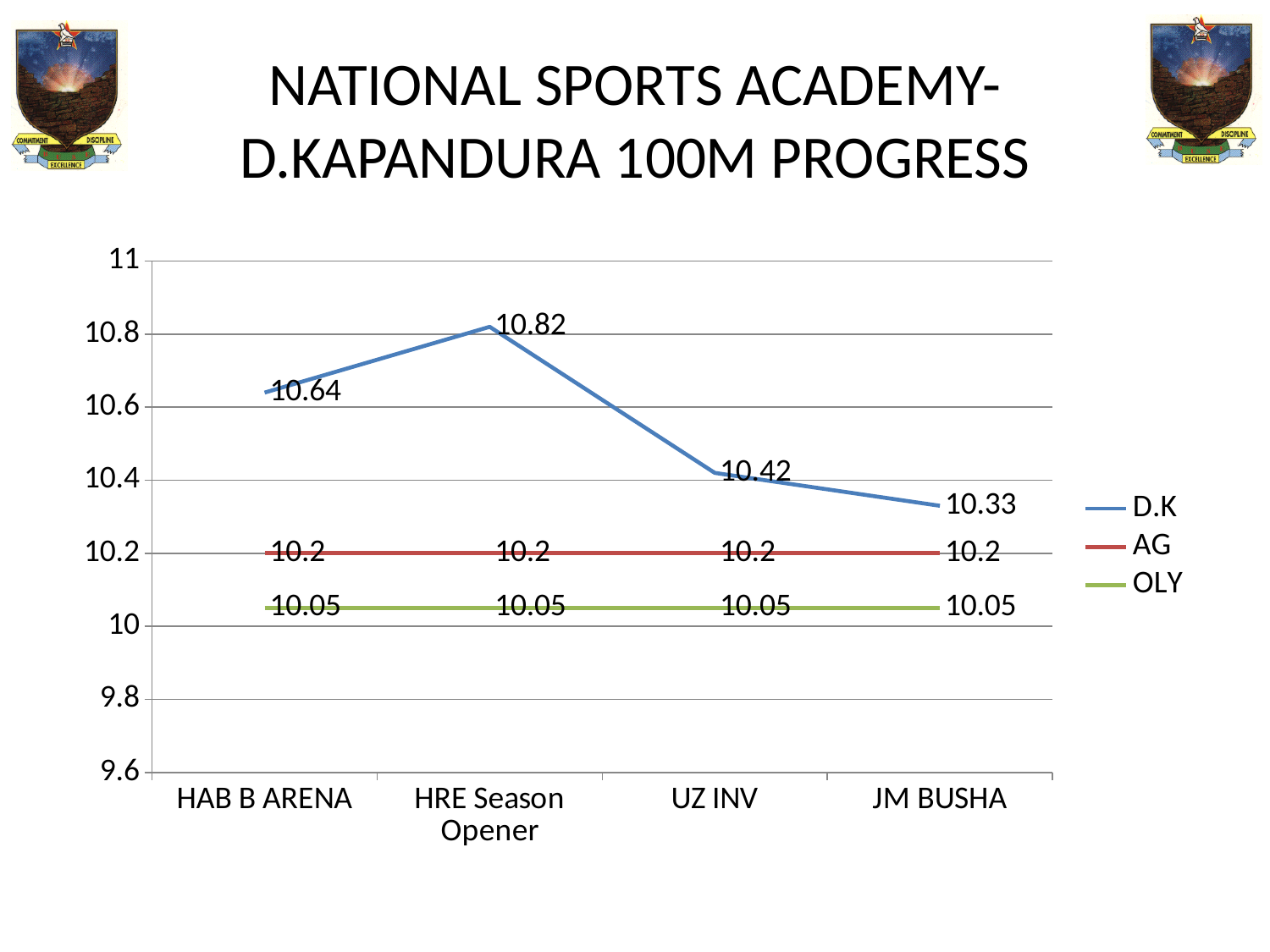
What is the D.K value at HRE Season Opener? 10.82 At which event is the D.K value highest? HRE Season Opener What is the OLY value at HAB B ARENA? 10.05 How many events are shown on the x axis? 4 What kind of chart is shown on the slide? Line chart At which event is the D.K value lowest? JM BUSHA What is the AG value at UZ INV? 10.2 What is the D.K value at JM BUSHA? 10.33 Does the D.K line rise or fall from HRE Season Opener to JM BUSHA? Fall Which is larger, the D.K value at HAB B ARENA or at UZ INV? HAB B ARENA What is the difference between the D.K value at HRE Season Opener and at UZ INV? 0.4 How many series does the legend list? 3